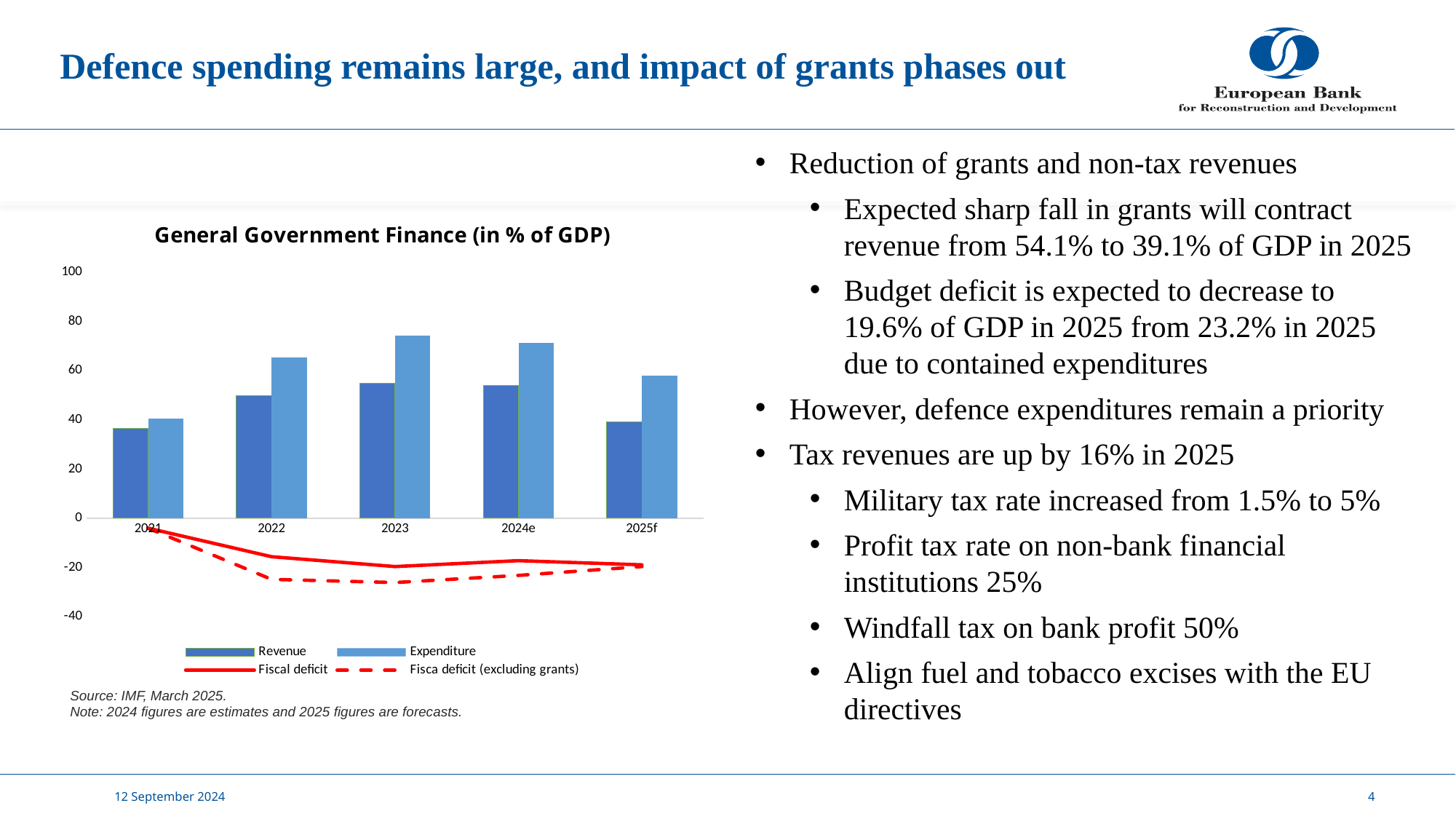
What is the title of the chart? General Government Finance (in % of GDP) In which year is the Revenue bar lowest? 2021 Which series is drawn as a dashed red line? Fisca deficit (excluding grants) How many series does the chart legend list? 4 Does the Expenditure series rise or fall from 2023 to 2025f? fall Is the Revenue value for 2021 greater or less than 40? less In 2023, which is larger, Revenue or Expenditure? Expenditure In which year is the Expenditure bar highest? 2023 What kind of chart is shown on the slide? Bar chart with line series Is the Expenditure value for 2023 greater or less than 60? greater How many years are shown on the x axis of the chart? 5 Is the Revenue value for 2022 greater or less than 40? greater